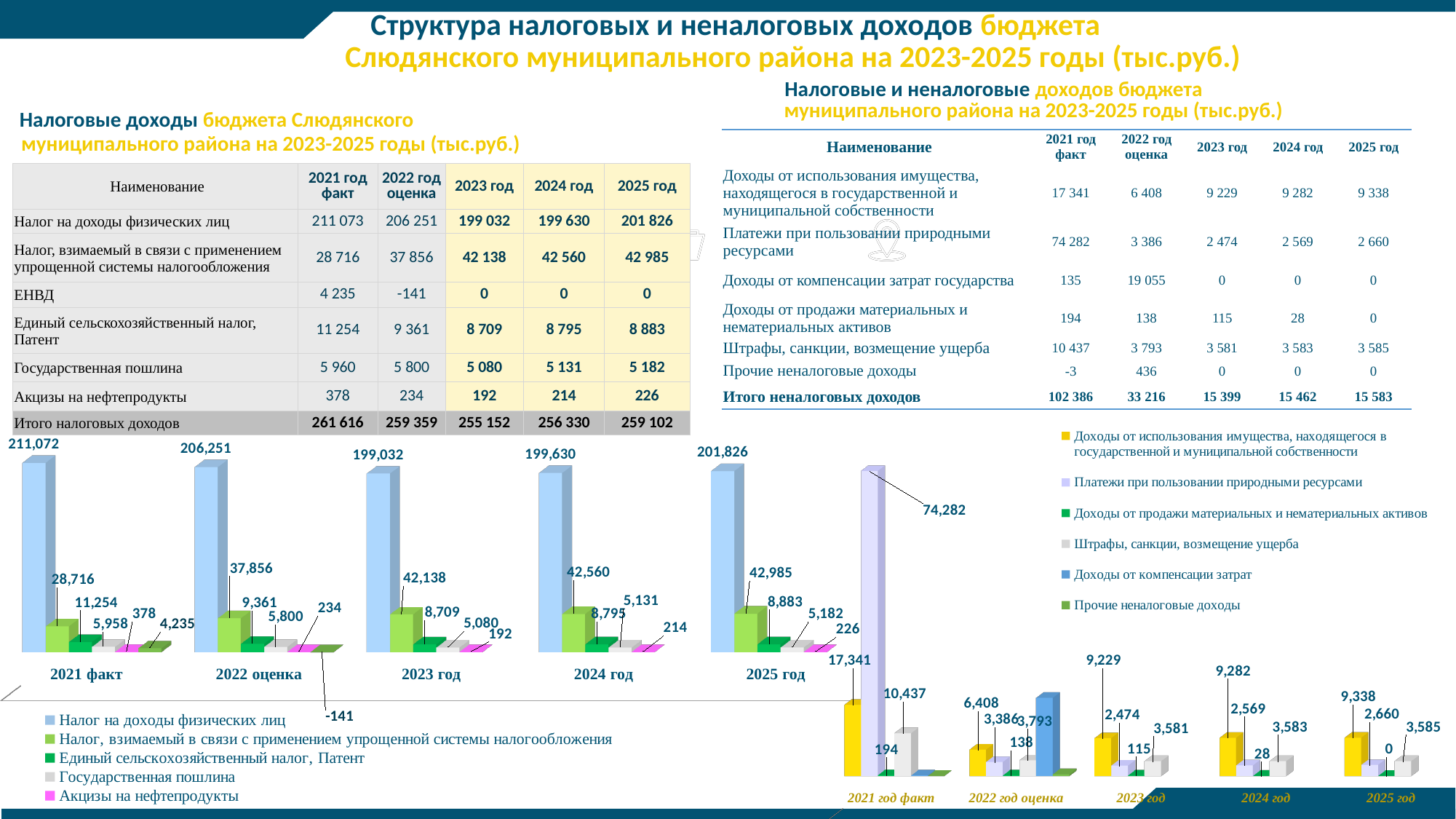
In the left chart (Налоговые доходы), what is the value of Налог на доходы физических лиц for 2021 факт? 211,072 In the left chart (Налоговые доходы), what is the value of Налог, взимаемый в связи с применением упрощенной системы налогообложения for 2025 год? 42,985 In the left chart (Налоговые доходы), what is the difference between Налог на доходы физических лиц in 2021 факт and in 2022 оценка? 4,821 In the left chart (Налоговые доходы), which category has the highest value for Налог на доходы физических лиц? 2021 факт In the left chart (Налоговые доходы), which is larger: Акцизы на нефтепродукты in 2021 факт or in 2025 год? 2021 факт In the right chart (Налоговые и неналоговые доходы), how many series does the legend list? 6 In the left chart (Налоговые доходы), how many categories are shown on the x axis? 5 In the left chart (Налоговые доходы), what is the value of Государственная пошлина for 2023 год? 5,080 In the right chart (Налоговые и неналоговые доходы), does the value of Доходы от использования имущества rise or fall from 2023 год to 2025 год? rise In the right chart (Налоговые и неналоговые доходы), what is the value of Платежи при пользовании природными ресурсами for 2021 год факт? 74,282 What type of chart is the left chart (Налоговые доходы)? bar chart In the right chart (Налоговые и неналоговые доходы), what is the value of Штрафы, санкции, возмещение ущерба for 2025 год? 3,585